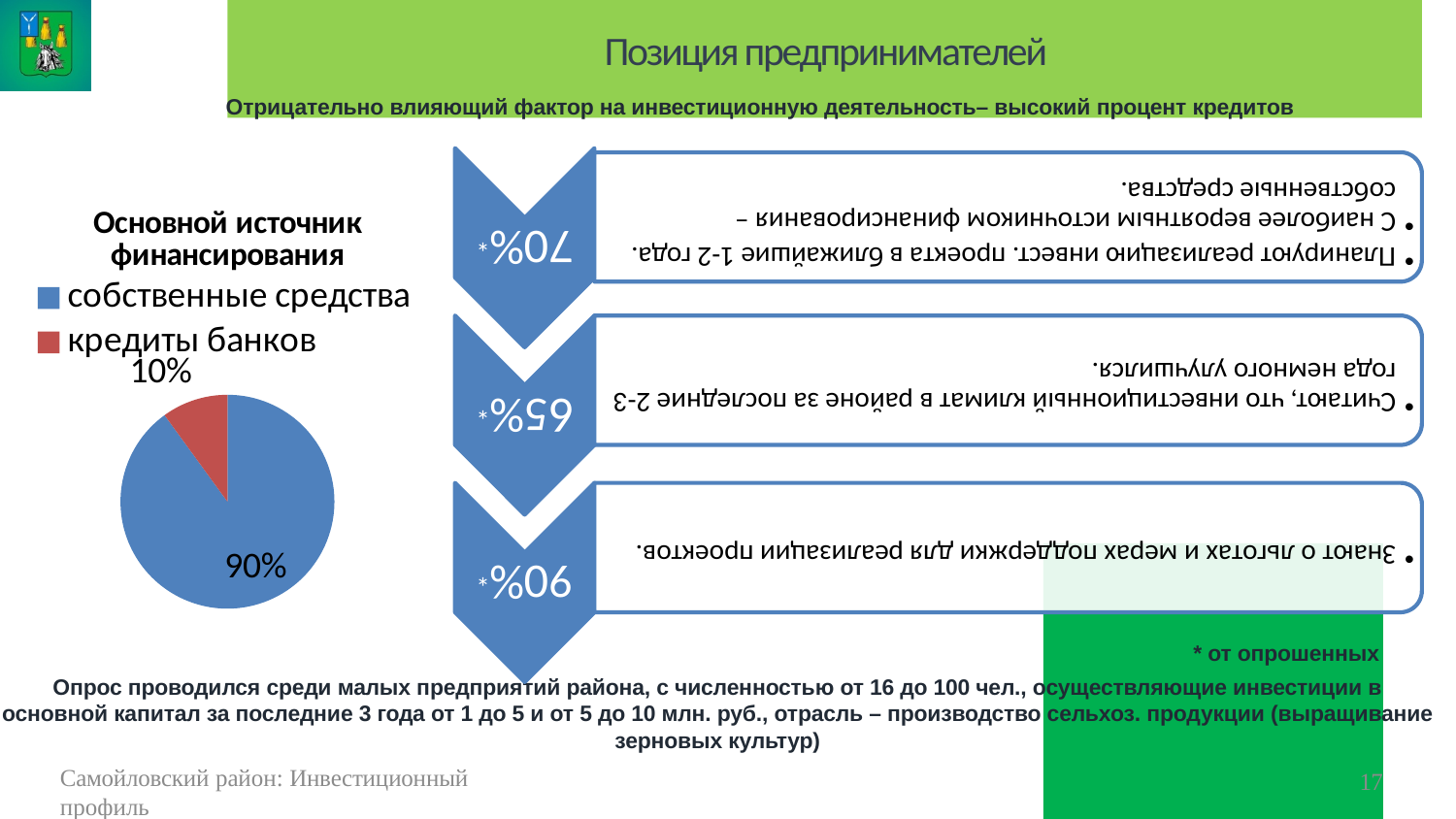
Which is larger: the share of "собственные средства" or the share of "кредиты банков"? собственные средства Which category has the smallest slice of the pie? кредиты банков What is the title of the pie chart? Основной источник финансирования How many categories does the pie chart show? 2 What is the total of the two slices shown in the pie chart? 100% Which category has the largest slice of the pie? собственные средства What is the difference between the shares of "собственные средства" and "кредиты банков"? 80% How many entries does the legend of the pie chart list? 2 What share of the pie does "кредиты банков" have? 10% What share of the pie does "собственные средства" have? 90% What kind of chart is shown on the slide? pie chart What colour is the "кредиты банков" slice in the pie chart? red